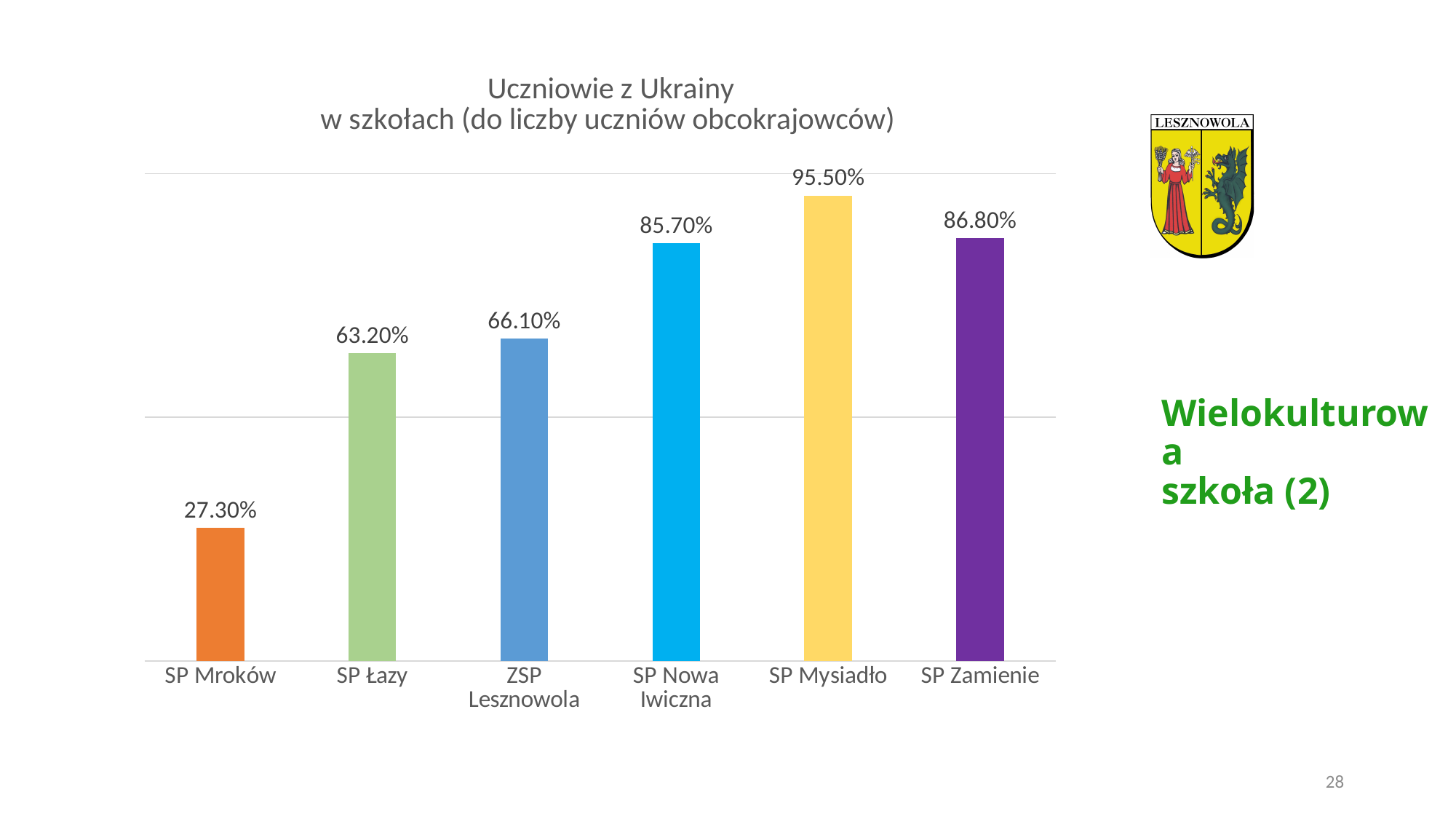
Which school has the highest value? SP Mysiadło Which school has the lowest value? SP Mroków What is the difference between the values for SP Mysiadło and SP Mroków? 68.20% What is the title of the chart? Uczniowie z Ukrainy w szkołach (do liczby uczniów obcokrajowców) What is the value for ZSP Lesznowola? 66.10% Which is larger, the value for SP Łazy or the value for SP Nowa Iwiczna? SP Nowa Iwiczna What is the value for SP Nowa Iwiczna? 85.70% What is the value for SP Zamienie? 86.80% How many schools are shown in the chart? 6 What is the value for SP Łazy? 63.20% What is the value for SP Mroków? 27.30% What kind of chart is shown on the slide? Bar chart